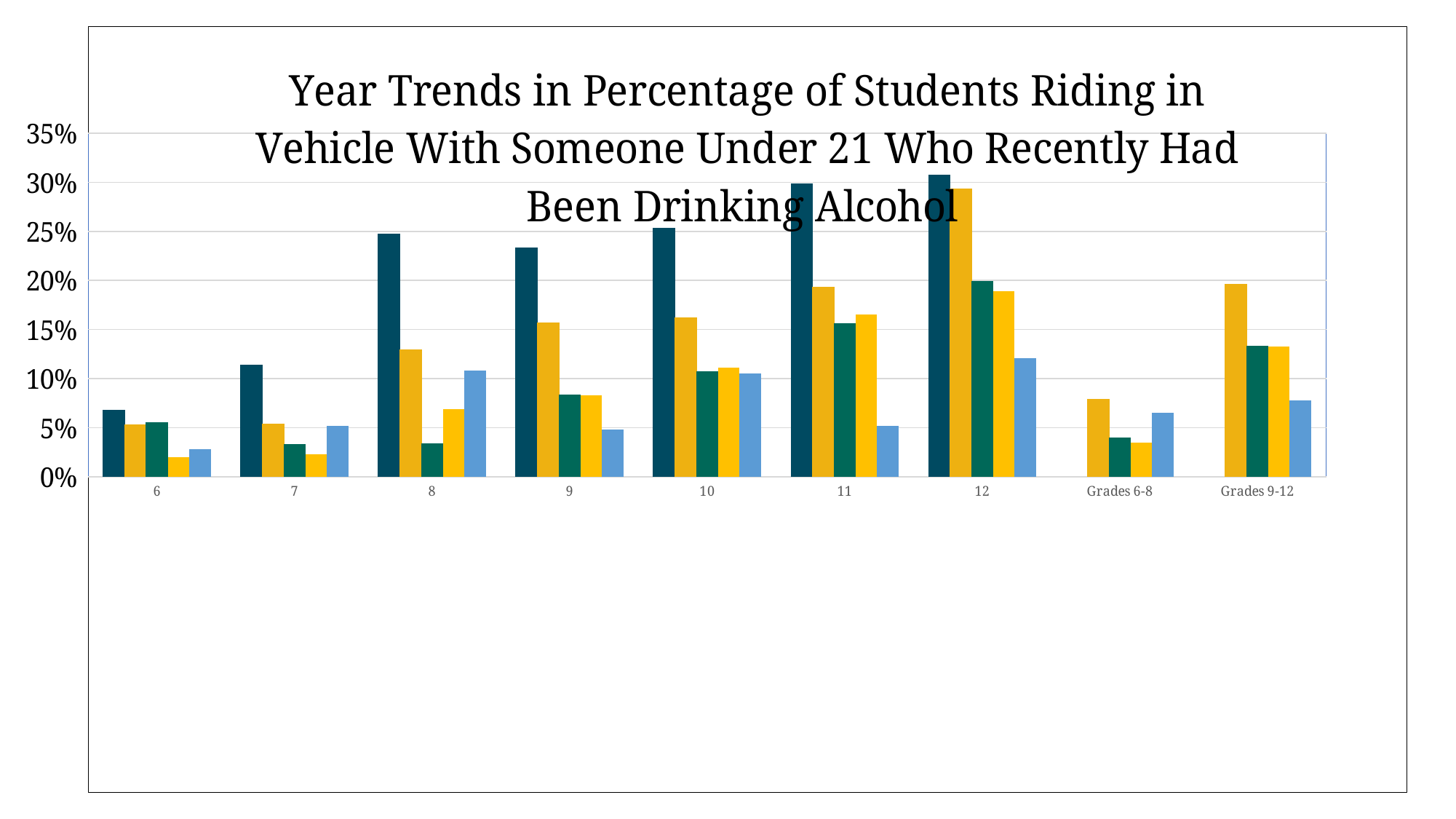
Do the orange (second) bars rise or fall from grade 6 to grade 12? rise How many categories are shown along the x axis? 9 Which is larger: the light blue bar for grade 8 or the light blue bar for grade 9? grade 8 Is the value of the dark teal (first) bar for grade 8 greater or less than 20%? greater Is the value of the yellow bar for grade 6 greater or less than 5%? less Is the value of the light blue (last) bar for grade 12 greater or less than 10%? greater How many bars are plotted for the Grades 6-8 category? 4 What is the title of the chart? Year Trends in Percentage of Students Riding in Vehicle With Someone Under 21 Who Recently Had Been Drinking Alcohol What kind of chart is shown on the slide? bar chart Among the orange (second) bars, which grade category has the highest value? 12